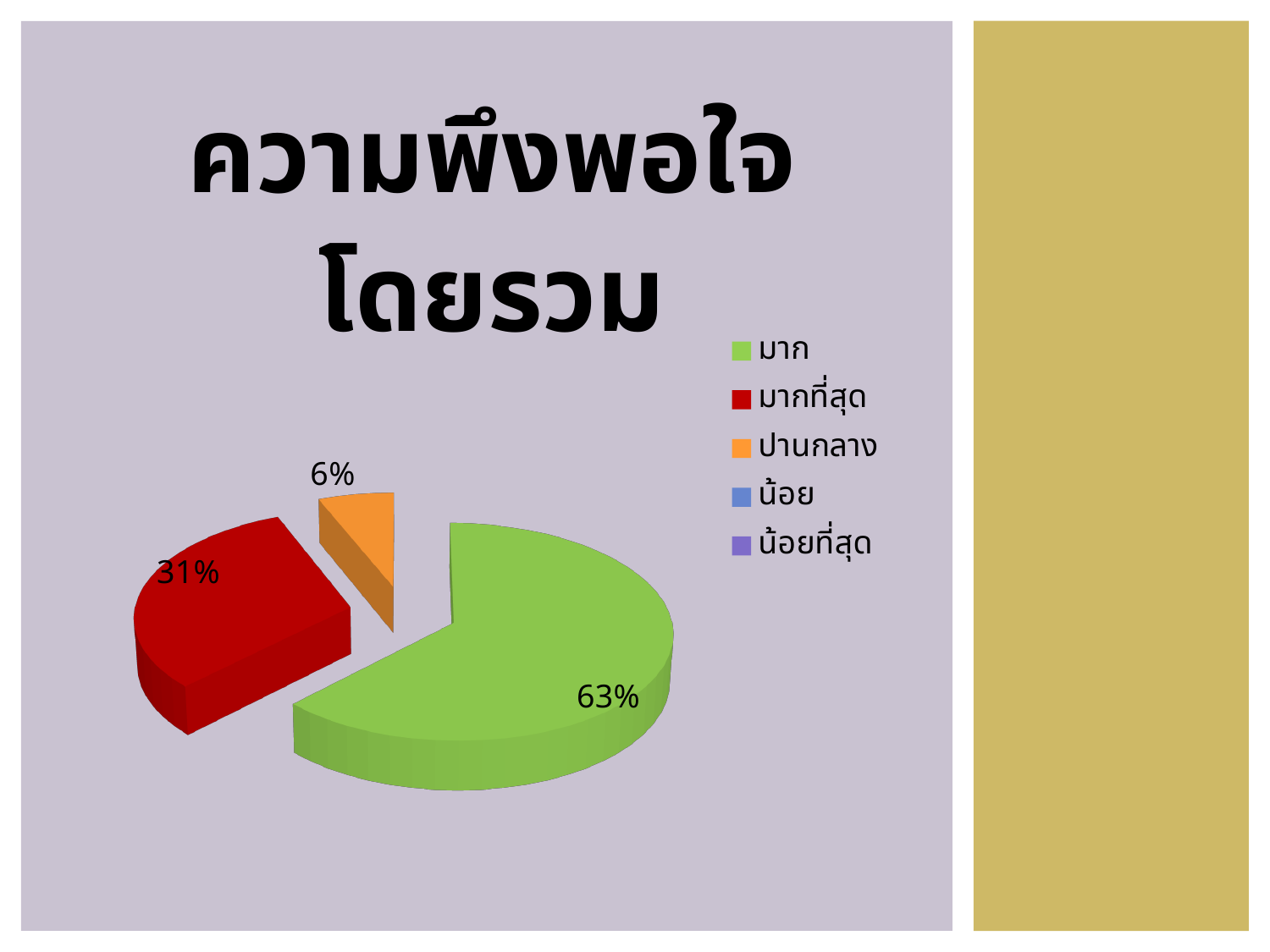
Which of the labelled slices is the smallest? ปานกลาง What kind of chart is shown on the slide? pie chart Which category has the largest slice of the pie? มาก What percentage is shown for มาก? 63% What percentage is shown for มากที่สุด? 31% Which is larger, the slice for มากที่สุด or the slice for ปานกลาง? มากที่สุด What percentage is shown for ปานกลาง? 6% What is the difference in percentage points between มาก and มากที่สุด? 32 What is the title of the chart? ความพึงพอใจโดยรวม How many categories does the legend list? 5 What is the difference in percentage points between มากที่สุด and ปานกลาง? 25 What colour is the slice for มากที่สุด? red